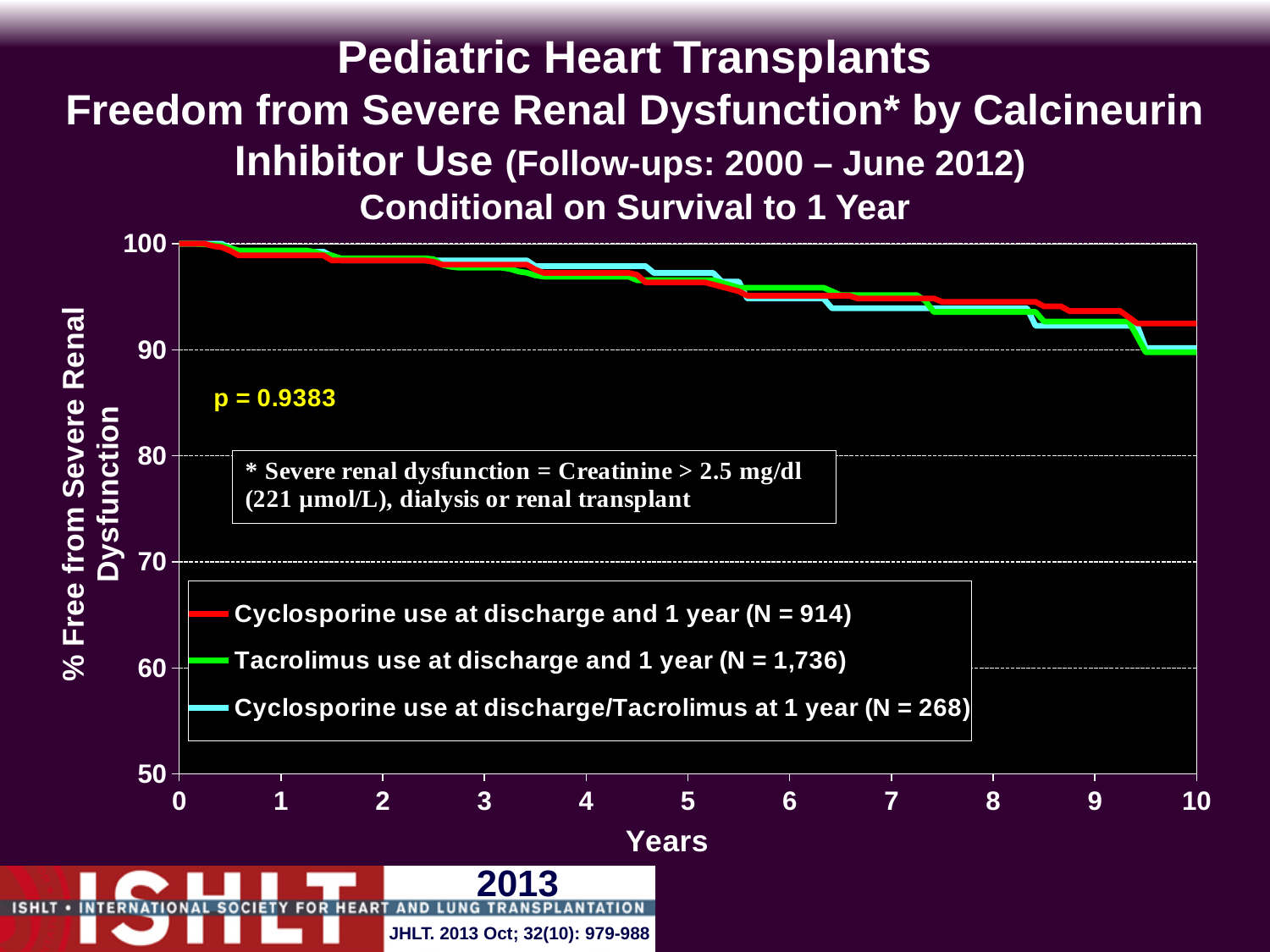
Do the plotted values rise or fall as the years increase along the x axis? fall How many year tick marks are labelled on the x axis? 11 Is the value for the Tacrolimus use at discharge and 1 year series at year 5 greater or less than 90? greater Is the value for the Cyclosporine use at discharge/Tacrolimus at 1 year series at year 8 greater or less than 80? greater At year 10, which is higher: the Cyclosporine use at discharge and 1 year series or the Tacrolimus use at discharge and 1 year series? Cyclosporine use at discharge and 1 year What kind of chart is shown on the slide? line chart How many series does the legend list? 3 What is the p-value printed on the chart? p = 0.9383 Is the value for the Cyclosporine use at discharge and 1 year series at year 10 greater or less than 90? greater Which series has the highest value at year 10? Cyclosporine use at discharge and 1 year What is the N for the Tacrolimus use at discharge and 1 year series shown in the legend? 1,736 What is the value of all three series at year 0? 100